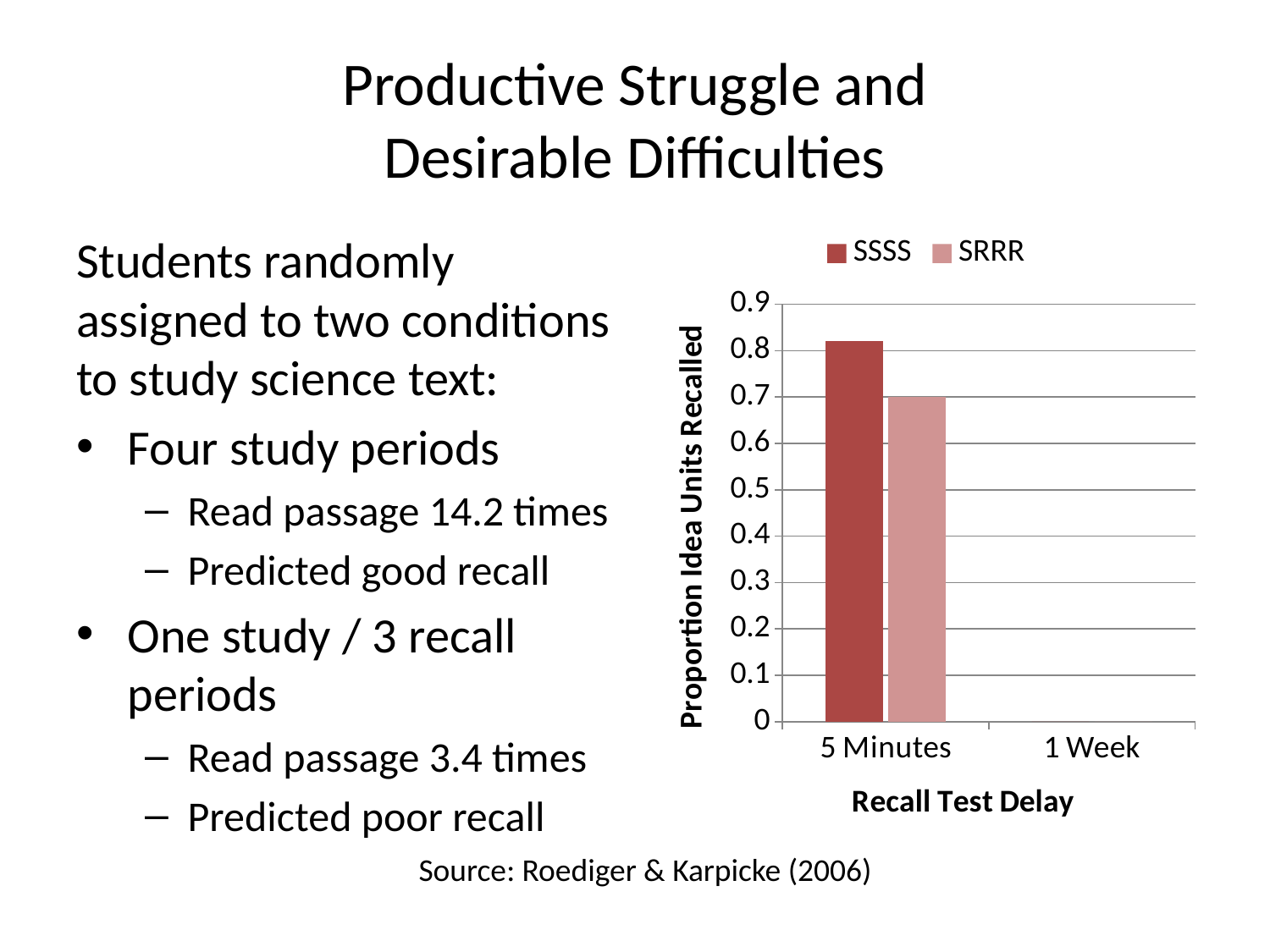
What kind of chart is shown on the slide? bar chart What are the two series named in the chart's legend? SSSS and SRRR How many series does the chart's legend list? 2 Which x-axis category in the chart has no bars plotted? 1 Week At the 5 Minutes recall test delay, which series has the higher proportion of idea units recalled, SSSS or SRRR? SSSS Is the value for SRRR at 5 Minutes greater or less than 0.8? less Is the value for SSSS at 5 Minutes greater or less than 0.7? greater Is the value for SSSS at 5 Minutes greater or less than 0.9? less What is the title of the chart's y axis? Proportion Idea Units Recalled How many categories are shown on the x axis of the chart? 2